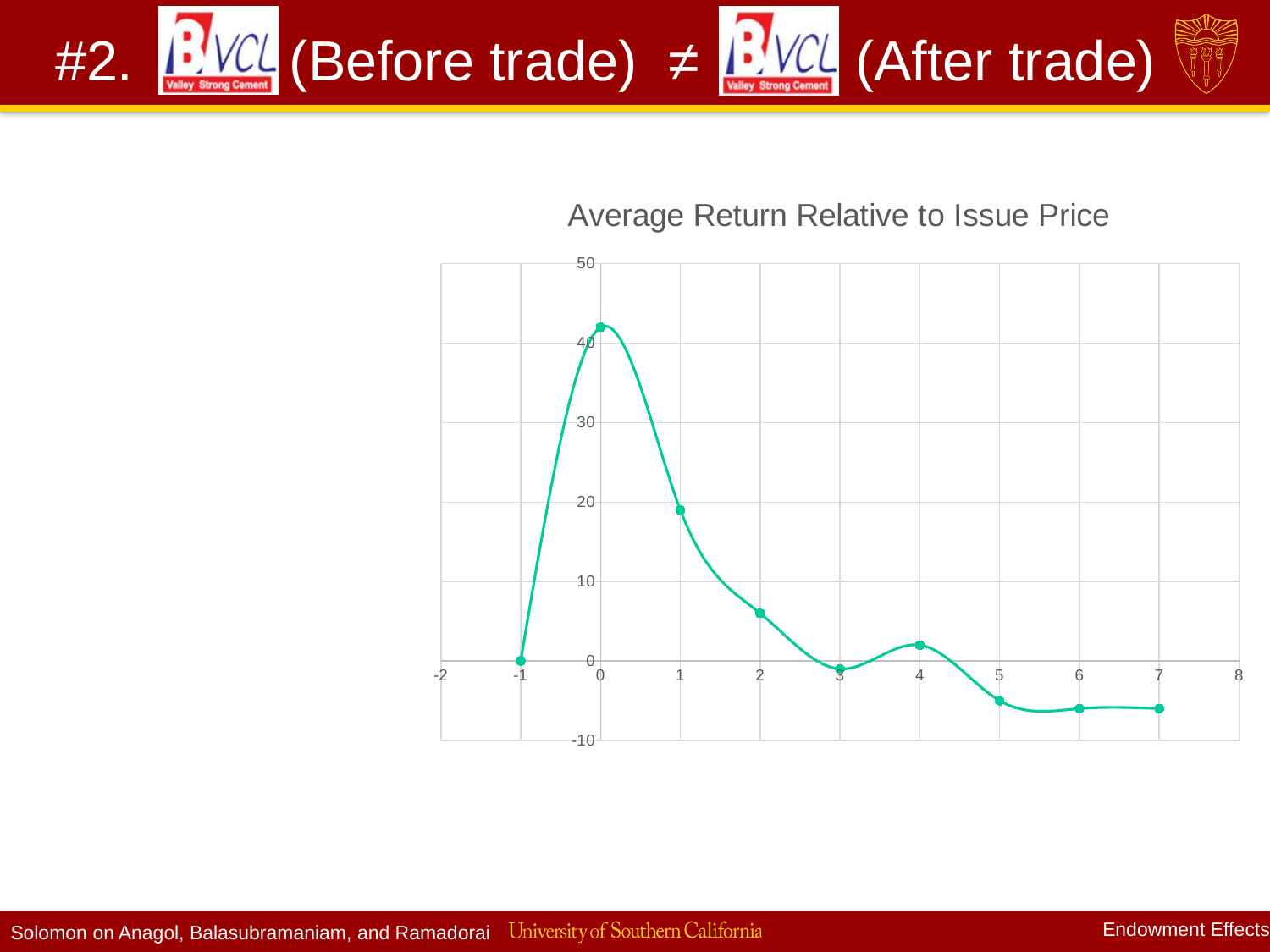
What type of chart is shown on the slide? line chart What is the value plotted at x = -1? 0 How many data points are plotted on the line? 9 What is the title of the chart? Average Return Relative to Issue Price Is the value at x = 2 greater or less than 10? less Is the value at x = 1 greater or less than 10? greater At which x value does the line reach its highest point? 0 Do the values rise or fall as x goes from 0 to 3? fall Is the value at x = 5 greater or less than 0? less Which has the larger value, x = 1 or x = 2? x = 1 What is the highest value shown on the vertical axis? 50